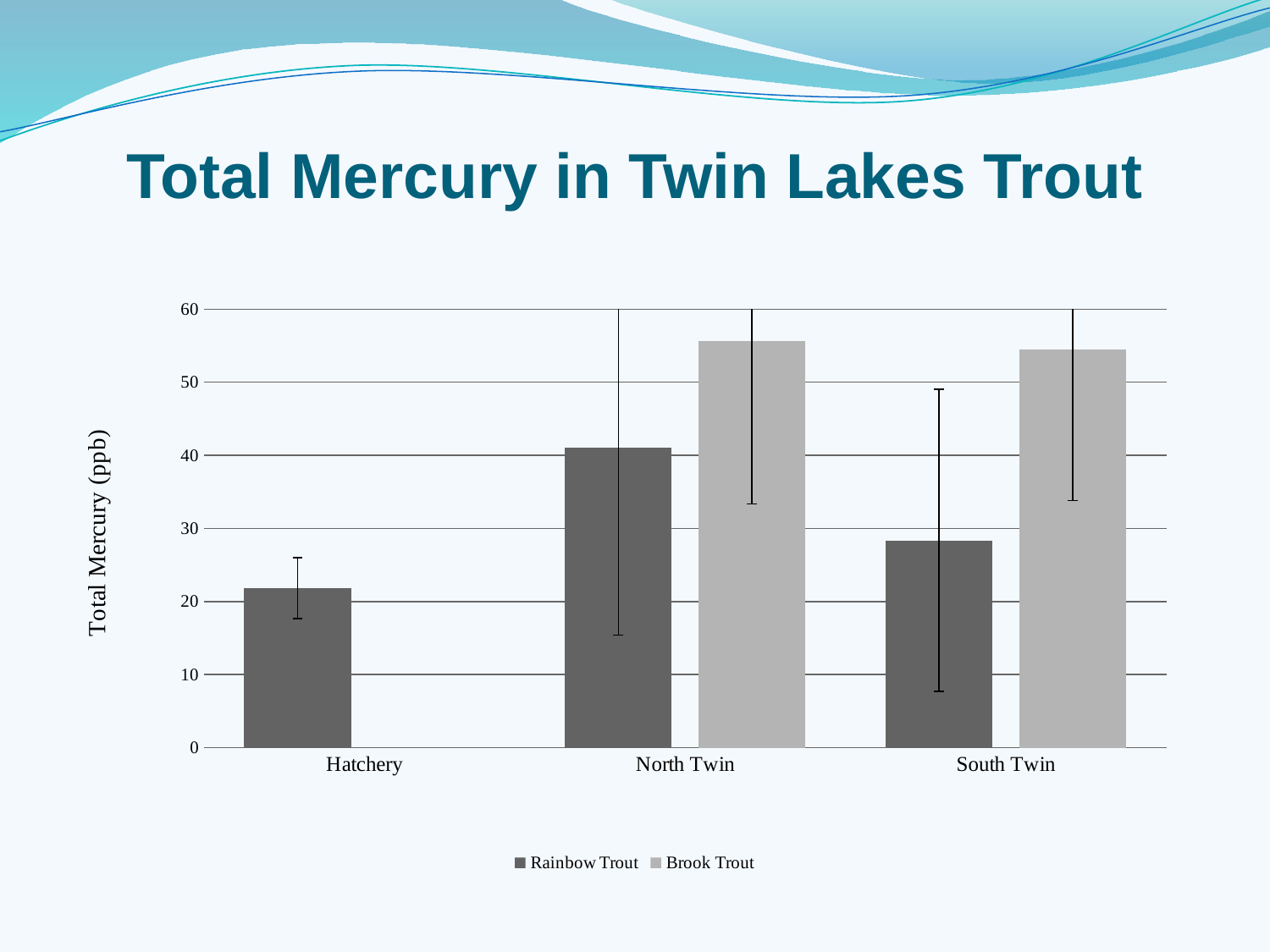
What is the title of the chart? Total Mercury in Twin Lakes Trout Is the Brook Trout value for North Twin greater or less than 50? greater How many series does the legend list? 2 What is the label of the vertical axis? Total Mercury (ppb) Is the Rainbow Trout value for South Twin greater or less than 20? greater Is the Rainbow Trout value for North Twin greater or less than 30? greater How many categories are shown on the x axis? 3 At North Twin, which series has the larger value, Rainbow Trout or Brook Trout? Brook Trout Which category has the highest Rainbow Trout value? North Twin What kind of chart is shown on the slide? Bar chart Which is larger, the Rainbow Trout value for North Twin or for South Twin? North Twin Which category has the lowest Rainbow Trout value? Hatchery